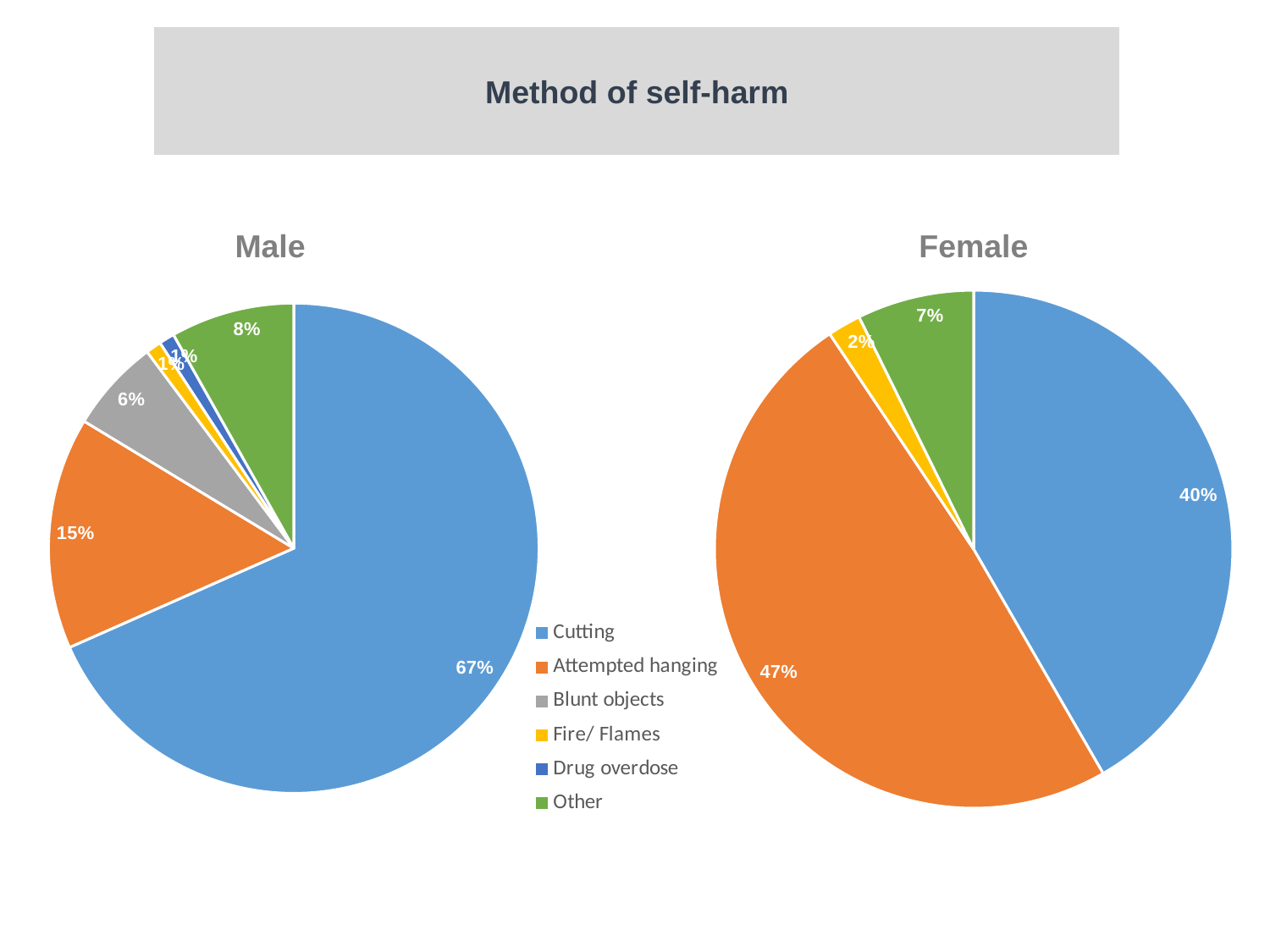
In the Male pie chart, what share is labelled for Blunt objects? 6% In the Female pie chart, what share is labelled for Attempted hanging? 47% In the Female pie chart, what share is labelled for Other? 7% In the Male pie chart, what share is labelled for Attempted hanging? 15% In the Female pie chart, what share is labelled for Cutting? 40% In the Male pie chart, what share is labelled for Other? 8% In the Male pie chart, what share is labelled for Cutting? 67% In the Male pie chart, which method has the largest slice? Cutting In the Female pie chart, which method has the largest slice? Attempted hanging In the Female pie chart, which is larger: Cutting or Attempted hanging? Attempted hanging In the Male pie chart, how many percentage points larger is Cutting than Attempted hanging? 52 percentage points What type of chart is used for the Male and Female data on this slide? Pie chart